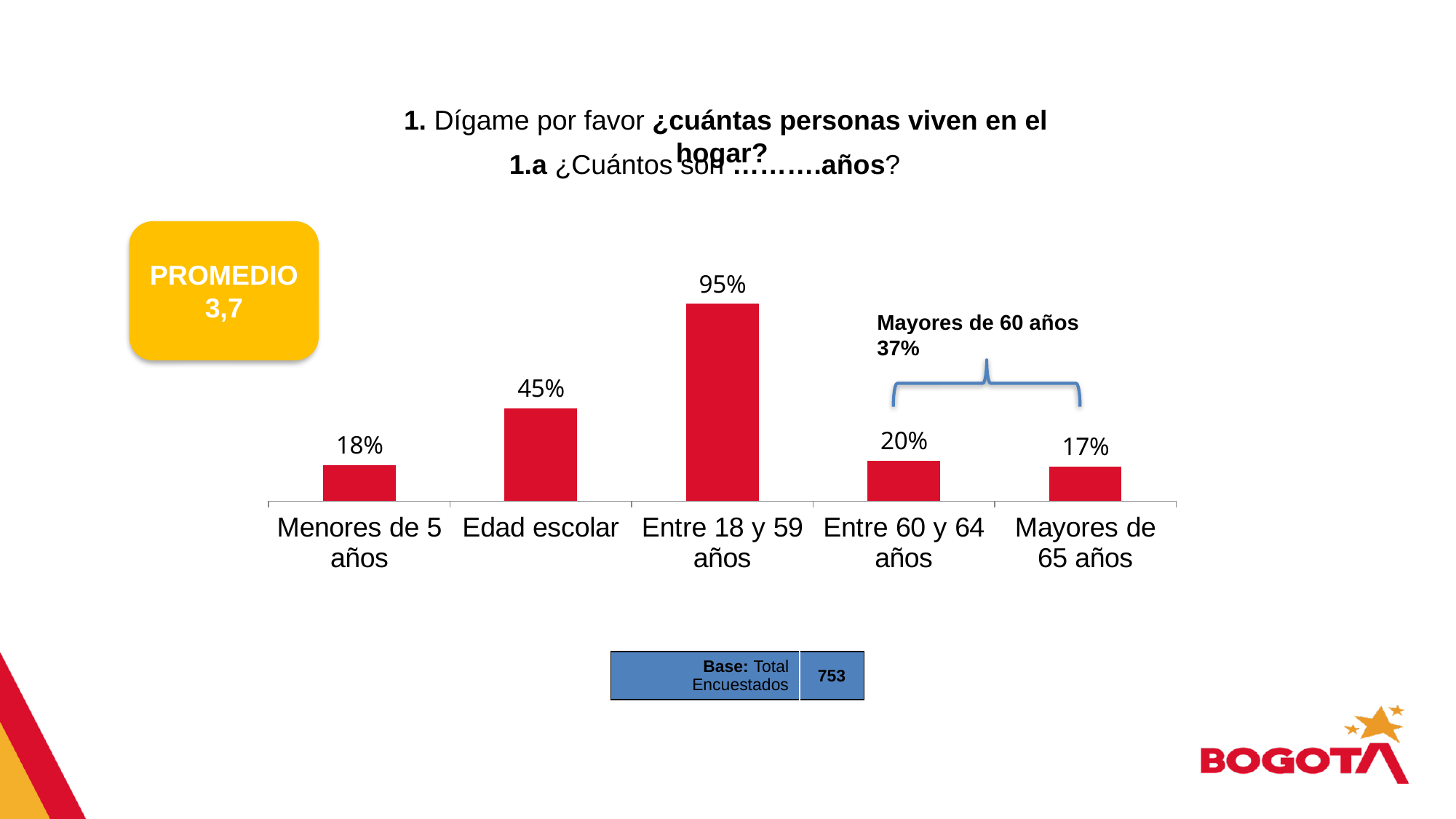
What percentage is given for 'Mayores de 60 años' in the annotation above the chart? 37% How many categories are shown in the chart? 5 Which category has the lowest value? Mayores de 65 años What is the value for 'Mayores de 65 años'? 17% What is the difference between 'Entre 18 y 59 años' and 'Edad escolar'? 50% What is the value for 'Entre 18 y 59 años'? 95% What is the value for 'Menores de 5 años'? 18% Which is larger, 'Edad escolar' or 'Menores de 5 años'? Edad escolar Which category has the highest value? Entre 18 y 59 años What kind of chart is shown on the slide? Bar chart What is the difference between 'Entre 60 y 64 años' and 'Mayores de 65 años'? 3% What is the value for 'Edad escolar'? 45%